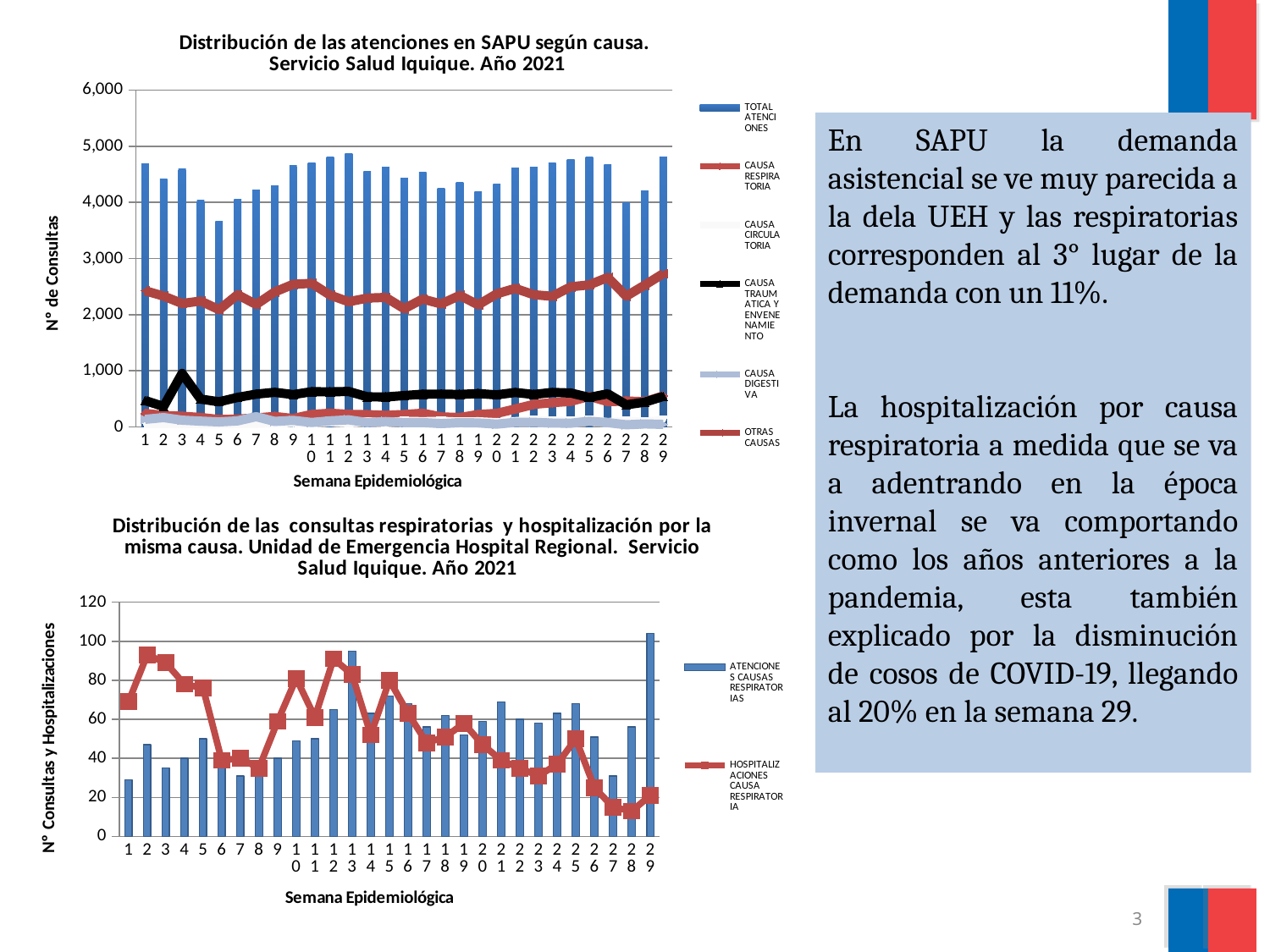
In the top chart (Distribución de las atenciones en SAPU según causa), is the TOTAL ATENCIONES value for week 5 greater or less than 4,000? less In the bottom chart (Distribución de las consultas respiratorias y hospitalización), which week has the highest ATENCIONES CAUSAS RESPIRATORIAS bar? 29 In the top chart (Distribución de las atenciones en SAPU según causa), how many epidemiological weeks are shown on the x axis? 29 In the bottom chart (Distribución de las consultas respiratorias y hospitalización), is the HOSPITALIZACIONES CAUSA RESPIRATORIA value for week 28 greater or less than 20? less In the bottom chart (Distribución de las consultas respiratorias y hospitalización), is the ATENCIONES CAUSAS RESPIRATORIAS value for week 29 greater or less than 100? greater In the top chart (Distribución de las atenciones en SAPU según causa), which week has the lowest TOTAL ATENCIONES bar? 5 In the bottom chart (Distribución de las consultas respiratorias y hospitalización), which week has the highest HOSPITALIZACIONES CAUSA RESPIRATORIA value? 2 In the top chart (Distribución de las atenciones en SAPU según causa), how many series does the legend list? 6 In the bottom chart (Distribución de las consultas respiratorias y hospitalización), how many series does the legend list? 2 In the top chart (Distribución de las atenciones en SAPU según causa), which series is drawn as a black line? CAUSA TRAUMATICA Y ENVENENAMIENTO In the top chart (Distribución de las atenciones en SAPU según causa), which is larger, the TOTAL ATENCIONES for week 5 or for week 12? week 12